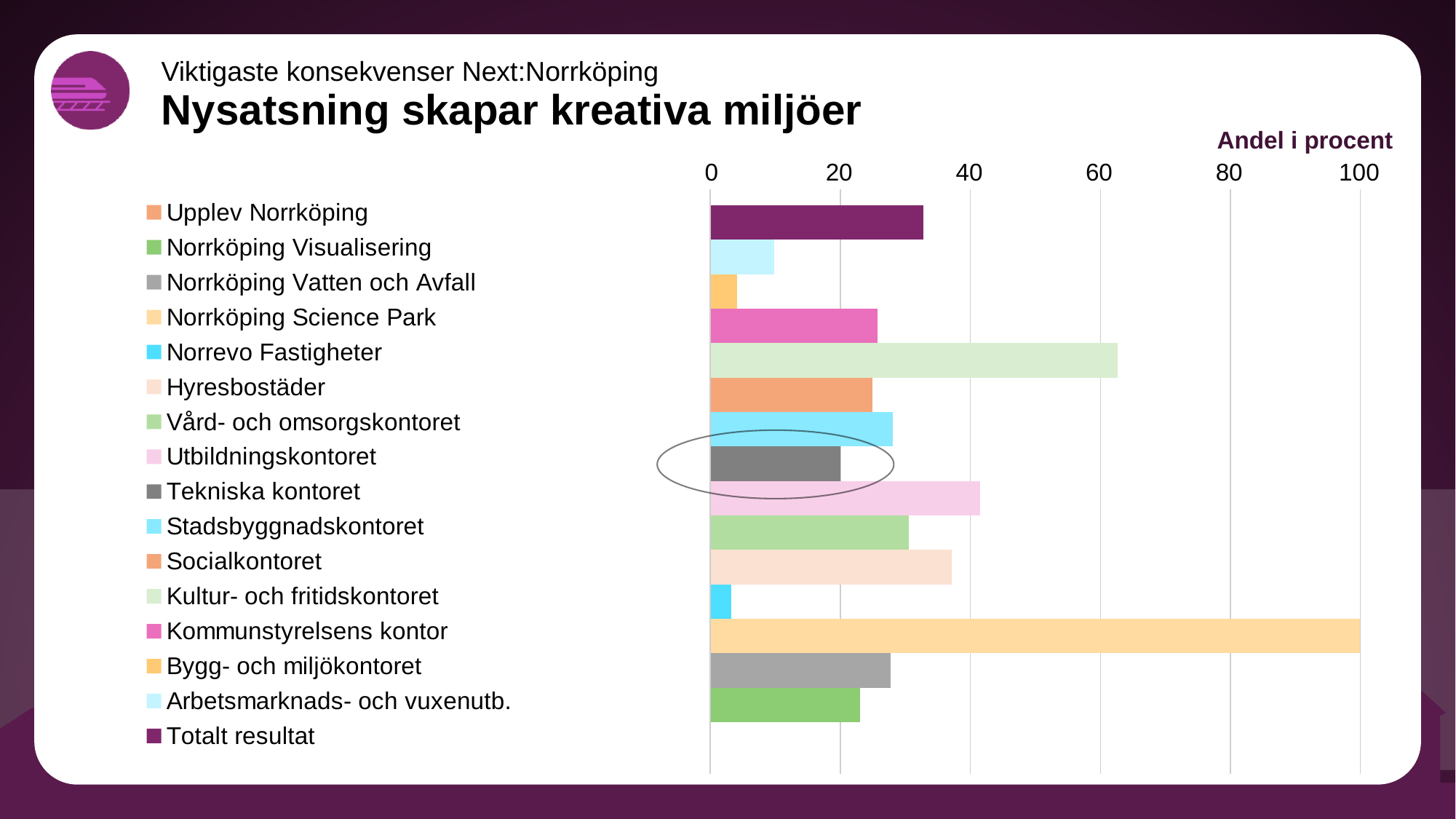
Is the value for Arbetsmarknads- och vuxenutb. greater or less than 20? less Is the value for Norrevo Fastigheter greater or less than 20? less Which is larger, the value for Utbildningskontoret or the value for Hyresbostäder? Utbildningskontoret Is the value for Totalt resultat greater or less than 40? less What kind of chart is shown on the slide? bar chart How many series does the legend list? 16 Which series has the highest value? Norrköping Science Park Which is larger, the value for Kultur- och fritidskontoret or the value for Totalt resultat? Kultur- och fritidskontoret What is the main title of the slide? Nysatsning skapar kreativa miljöer What is the value for Norrköping Science Park? 100 What label is shown above the horizontal axis of the chart? Andel i procent